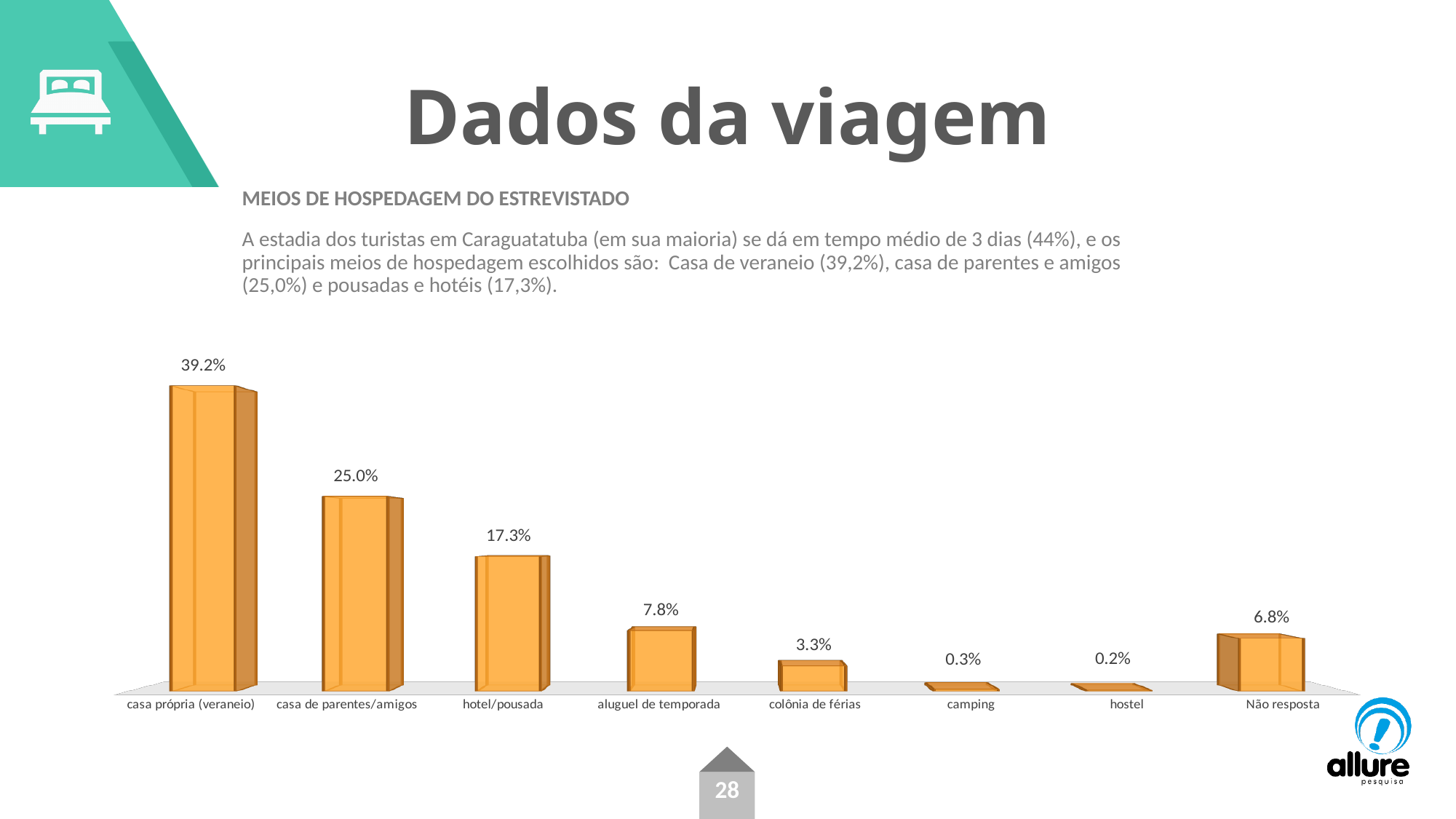
What is the difference between casa própria (veraneio) and casa de parentes/amigos? 14.2% What is the value for casa própria (veraneio)? 39.2% What is the value for camping? 0.3% Which category has the lowest value? hostel What is the value for Não resposta? 6.8% Which is larger, Não resposta or aluguel de temporada? aluguel de temporada What kind of chart is shown on the slide? bar chart Which category has the highest value? casa própria (veraneio) What colour are the bars in the chart? orange How many categories are shown in the chart? 8 What is the difference between aluguel de temporada and colônia de férias? 4.5% What is the value for hotel/pousada? 17.3%